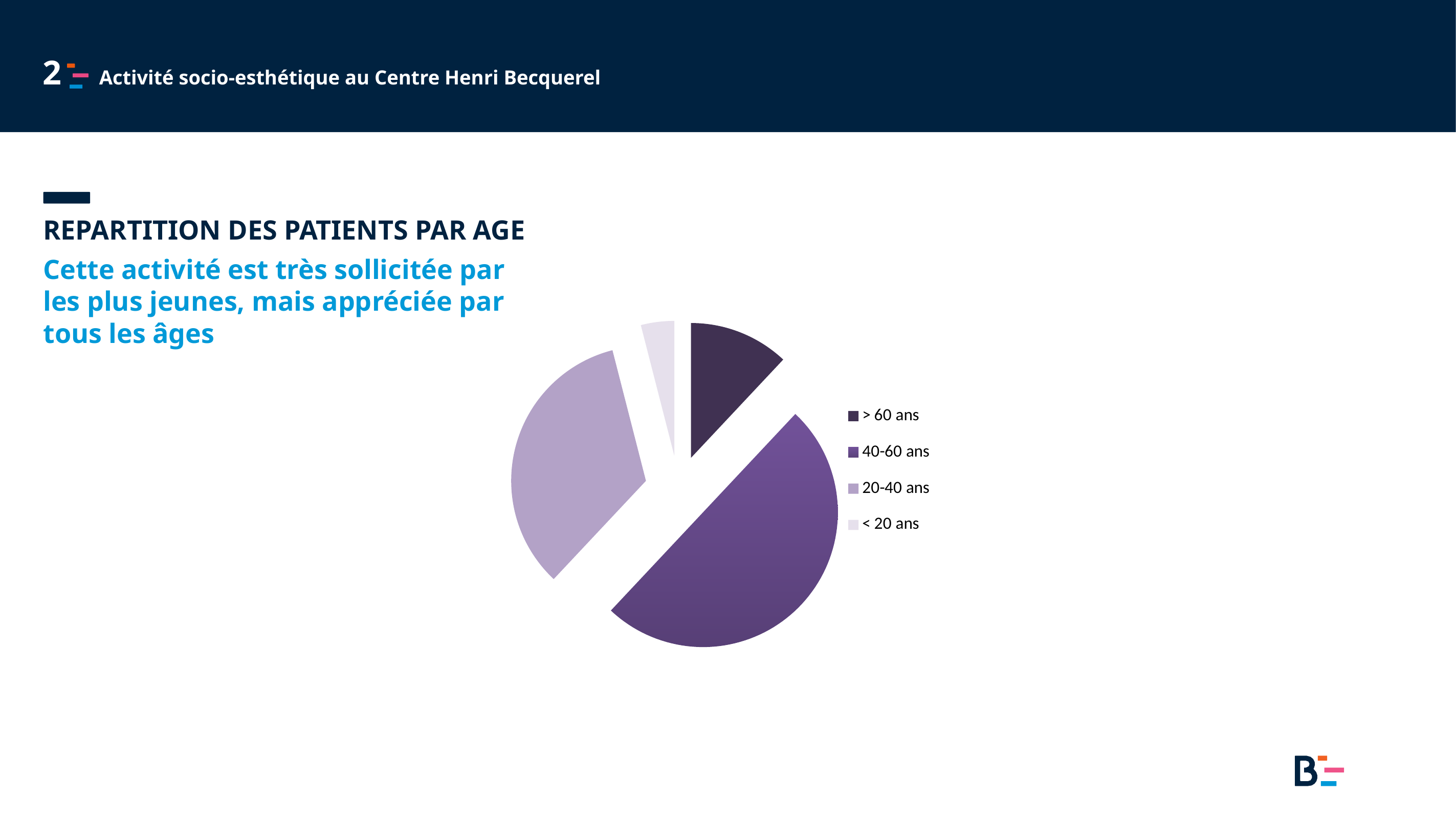
What kind of chart is shown on the slide? Pie chart Which slice is larger, 40-60 ans or 20-40 ans? 40-60 ans What is the title of the chart section on the slide? REPARTITION DES PATIENTS PAR AGE Which slice is larger, 20-40 ans or > 60 ans? 20-40 ans How many slices does the pie chart have? 4 Which slice is larger, > 60 ans or < 20 ans? > 60 ans Which legend entry is shown with the lightest colour? < 20 ans Which age group has the largest slice of the pie chart? 40-60 ans Which age group has the smallest slice of the pie chart? < 20 ans How many entries does the legend of the pie chart list? 4